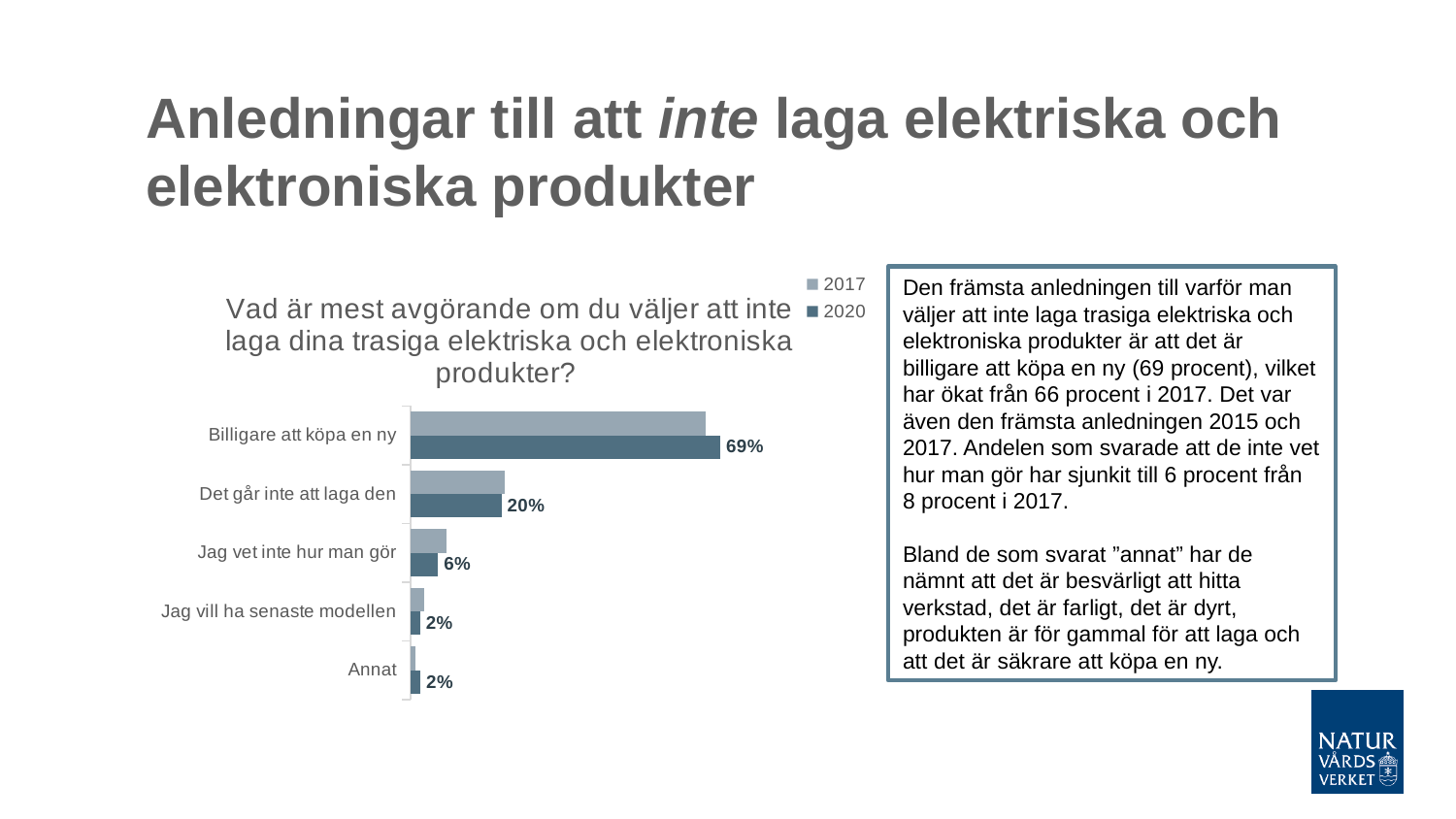
What kind of chart is shown on the slide? Bar chart Which category has the lowest 2017 value? Annat How many categories are shown in the chart? 5 How many series does the legend list? 2 What is the 2020 value for "Billigare att köpa en ny"? 69% What is the 2020 value for "Det går inte att laga den"? 20% What is the difference between the 2020 values for "Billigare att köpa en ny" and "Det går inte att laga den"? 49 percentage points Which category has the highest 2020 value? Billigare att köpa en ny Which has the larger 2020 value: "Det går inte att laga den" or "Jag vet inte hur man gör"? Det går inte att laga den What is the 2020 value for "Jag vet inte hur man gör"? 6% What is the 2020 value for "Jag vill ha senaste modellen"? 2% For "Annat", which series has the larger value: 2017 or 2020? 2020